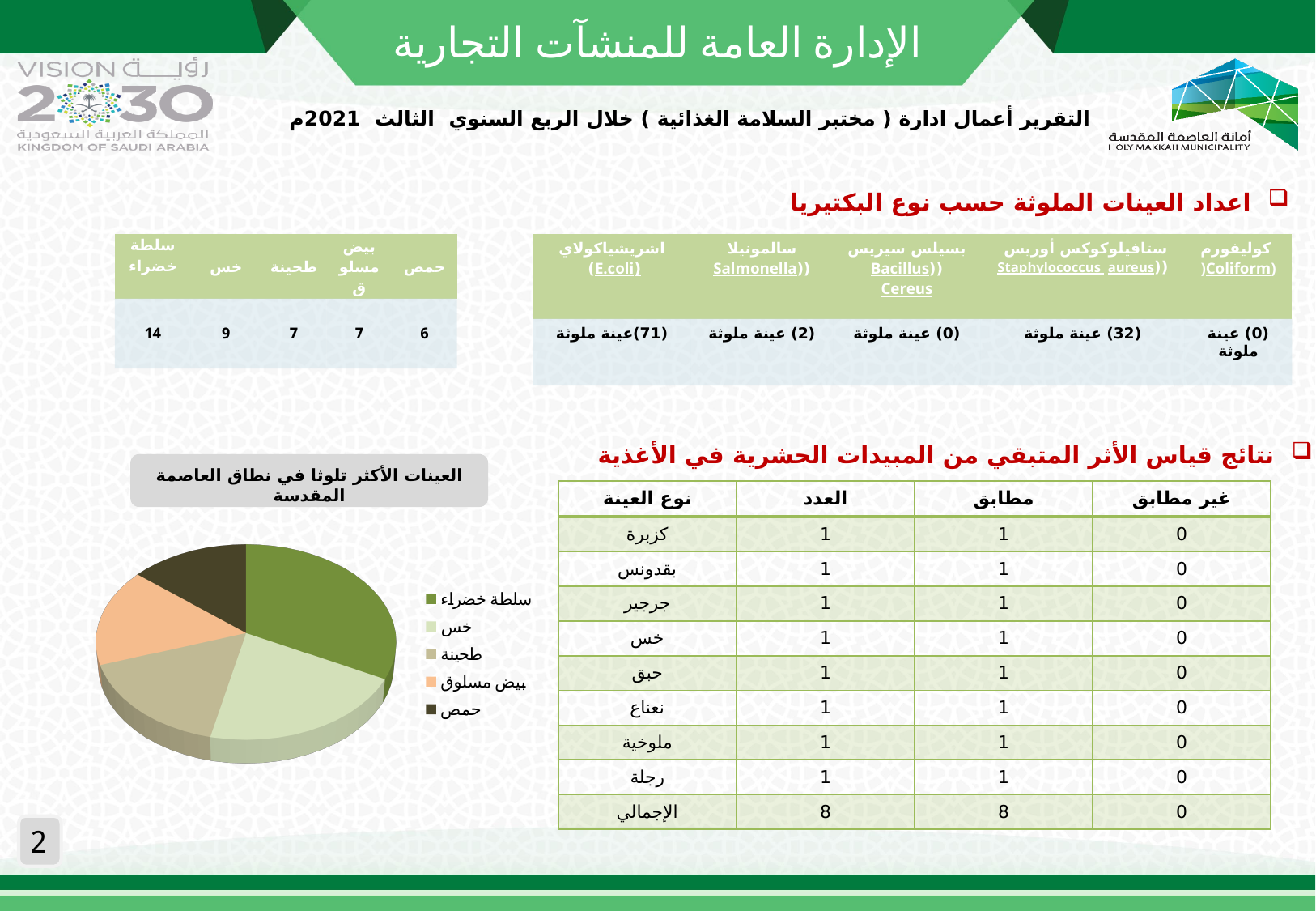
Which category has the largest slice in the pie chart? سلطة خضراء In the pie chart, which slice is larger: سلطة خضراء or حمص? سلطة خضراء What is the title of the pie chart? العينات الأكثر تلوثا في نطاق العاصمة المقدسة Which legend entry is shown in dark green in the pie chart? سلطة خضراء How many categories (slices) does the pie chart have? 5 In the pie chart, which slice is larger: خس or حمص? خس What kind of chart is shown on the slide? pie chart How many entries does the pie chart's legend list? 5